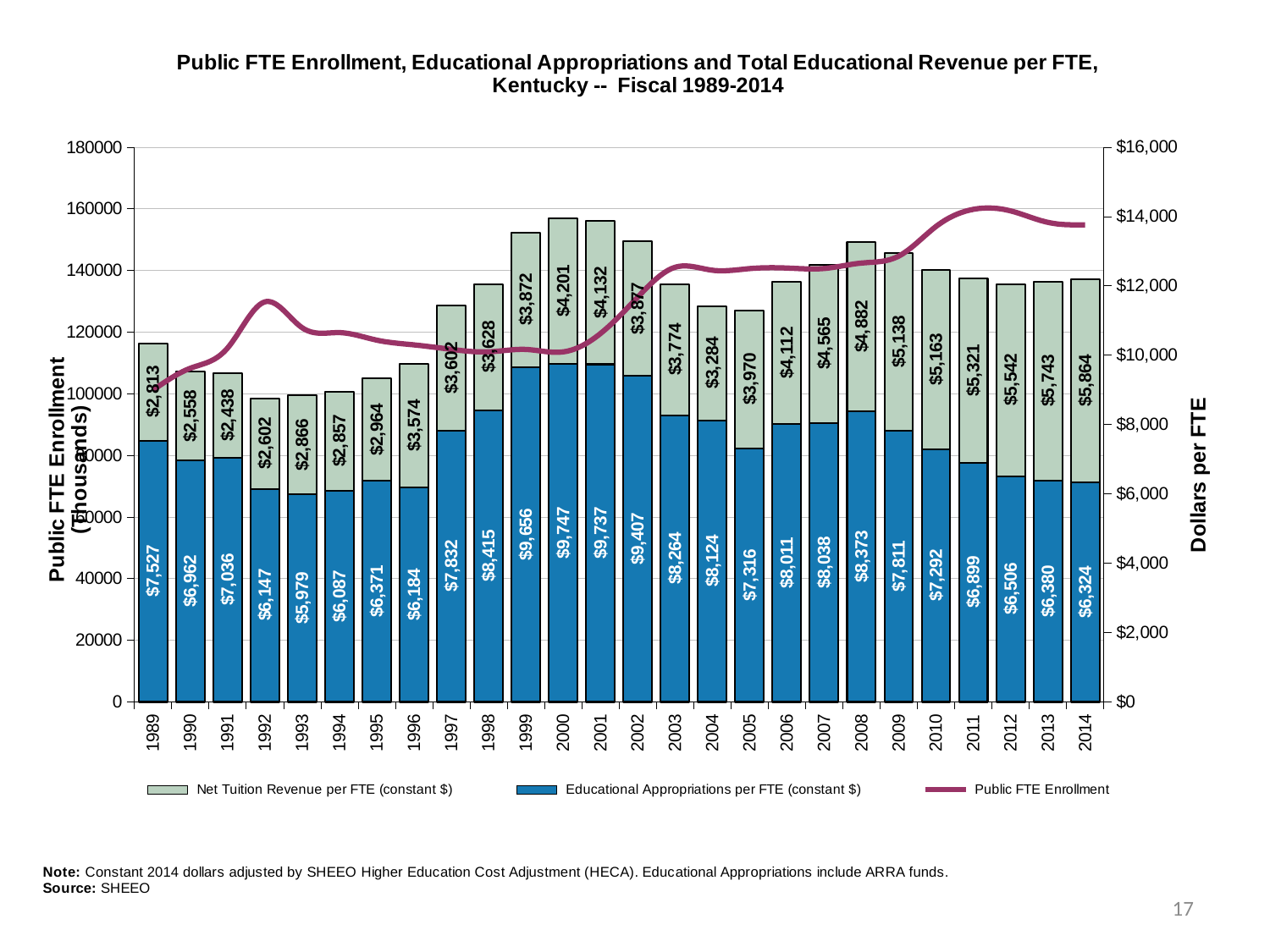
How many series does the legend list? 3 What is the difference between Educational Appropriations per FTE in 1989 and in 2014? $1,203 What is the Net Tuition Revenue per FTE value for 2014? $5,864 What is the Educational Appropriations per FTE value for 1993? $5,979 Which year has the lowest Net Tuition Revenue per FTE? 1991 Which is larger, Educational Appropriations per FTE in 1999 or in 2005? 1999 Does Net Tuition Revenue per FTE rise or fall from 2009 to 2014? rise How many fiscal years are shown on the x axis? 26 Is the Public FTE Enrollment value for 2014 greater or less than 140000? greater Which year has the highest Net Tuition Revenue per FTE? 2014 What is the Educational Appropriations per FTE value for 2000? $9,747 What is the total of the stacked bar (appropriations plus net tuition revenue) for 2014? $12,188